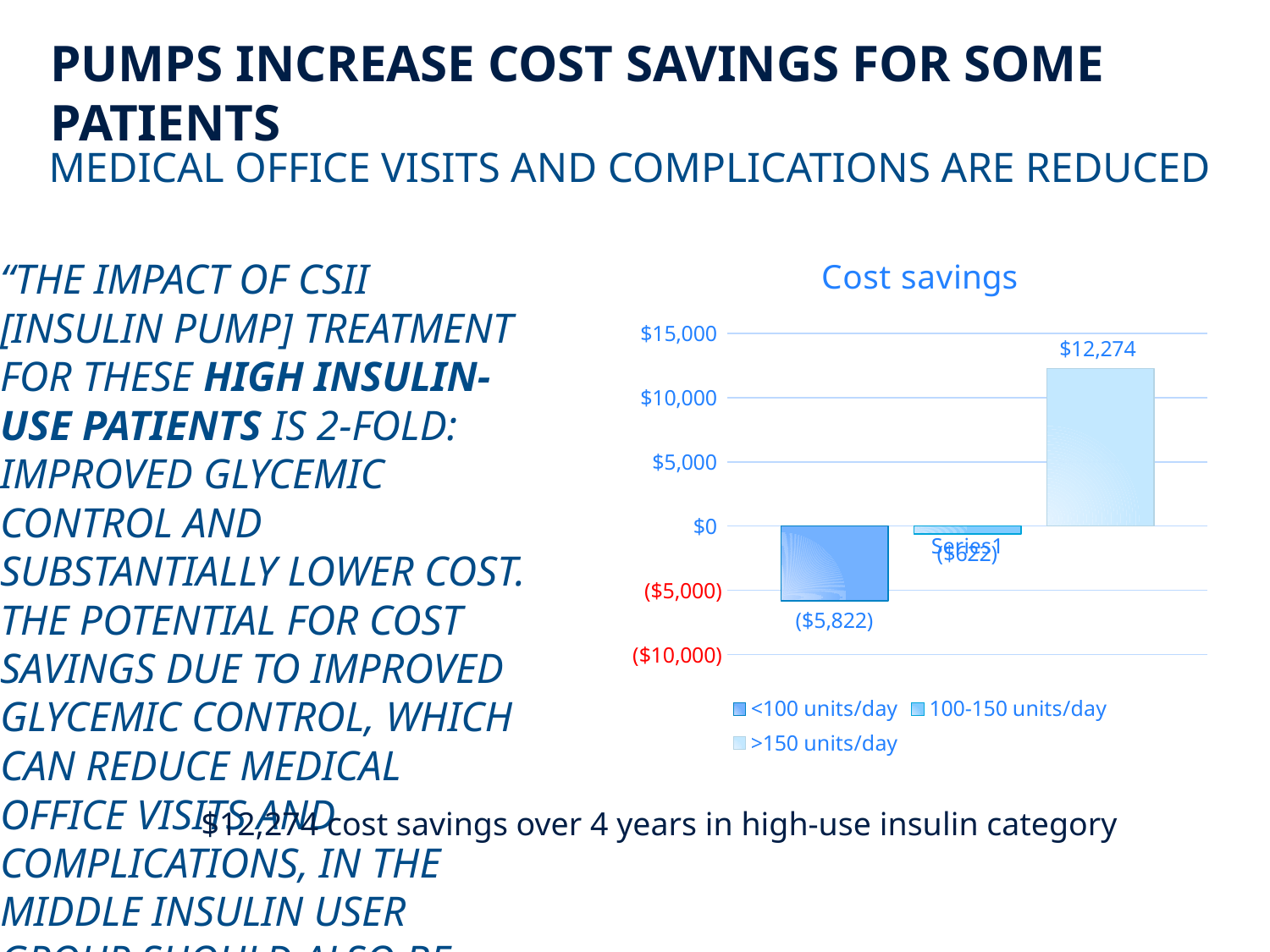
What are the legend entries of the Cost savings chart? <100 units/day, 100-150 units/day, >150 units/day What kind of chart is the Cost savings chart? bar chart In the Cost savings chart, what is the difference between the >150 units/day value and the <100 units/day value? $18,096 What is the title of the chart on the slide? Cost savings How many series does the legend of the Cost savings chart list? 3 In the Cost savings chart, which series has the highest value? >150 units/day In the Cost savings chart, what is the value for the <100 units/day series? ($5,822) In the Cost savings chart, which series has the lowest value? <100 units/day In the Cost savings chart, is the value for 100-150 units/day greater or less than $0? less In the Cost savings chart, which is larger: the value for >150 units/day or the value for <100 units/day? >150 units/day In the Cost savings chart, is the value for >150 units/day greater or less than $10,000? greater In the Cost savings chart, what is the value for the >150 units/day series? $12,274